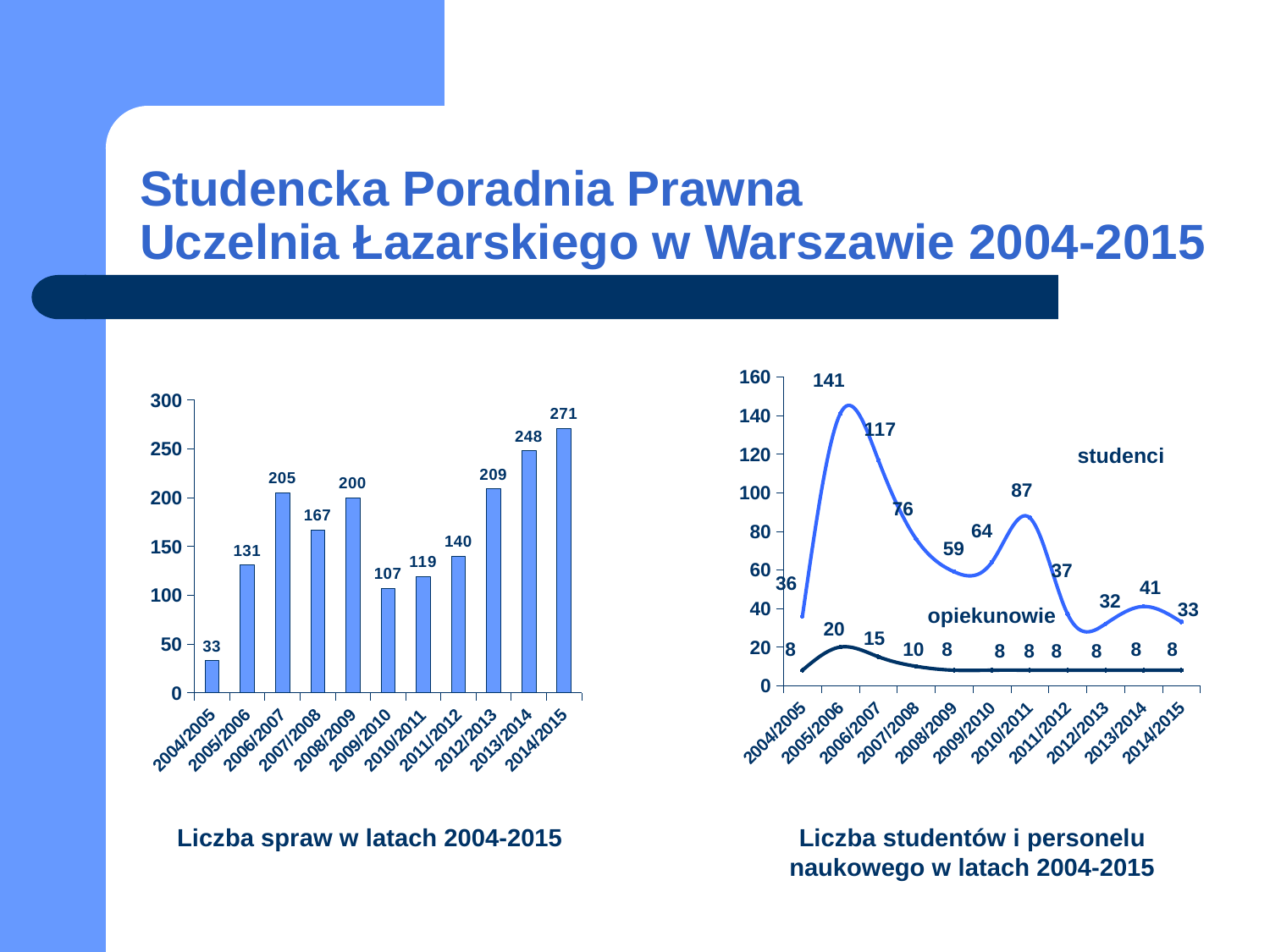
In the left chart (Liczba spraw w latach 2004-2015), which year has the highest number of cases? 2014/2015 In the right chart (Liczba studentów i personelu naukowego), what is the value for studenci in 2010/2011? 87 In the right chart (Liczba studentów i personelu naukowego), what is the difference between studenci and opiekunowie in 2006/2007? 102 In the right chart (Liczba studentów i personelu naukowego), how many series are plotted? 2 In the right chart (Liczba studentów i personelu naukowego), in which year is the studenci value highest? 2005/2006 In the left chart (Liczba spraw w latach 2004-2015), which year has the lowest value? 2004/2005 In the left chart (Liczba spraw w latach 2004-2015), which is larger, the value for 2006/2007 or 2008/2009? 2006/2007 What kind of chart is the left chart (Liczba spraw w latach 2004-2015)? bar chart In the left chart (Liczba spraw w latach 2004-2015), what is the difference between the values for 2013/2014 and 2012/2013? 39 In the left chart (Liczba spraw w latach 2004-2015), what is the value for 2008/2009? 200 In the right chart (Liczba studentów i personelu naukowego), what is the value for opiekunowie in 2005/2006? 20 In the left chart (Liczba spraw w latach 2004-2015), how many years are shown on the x axis? 11